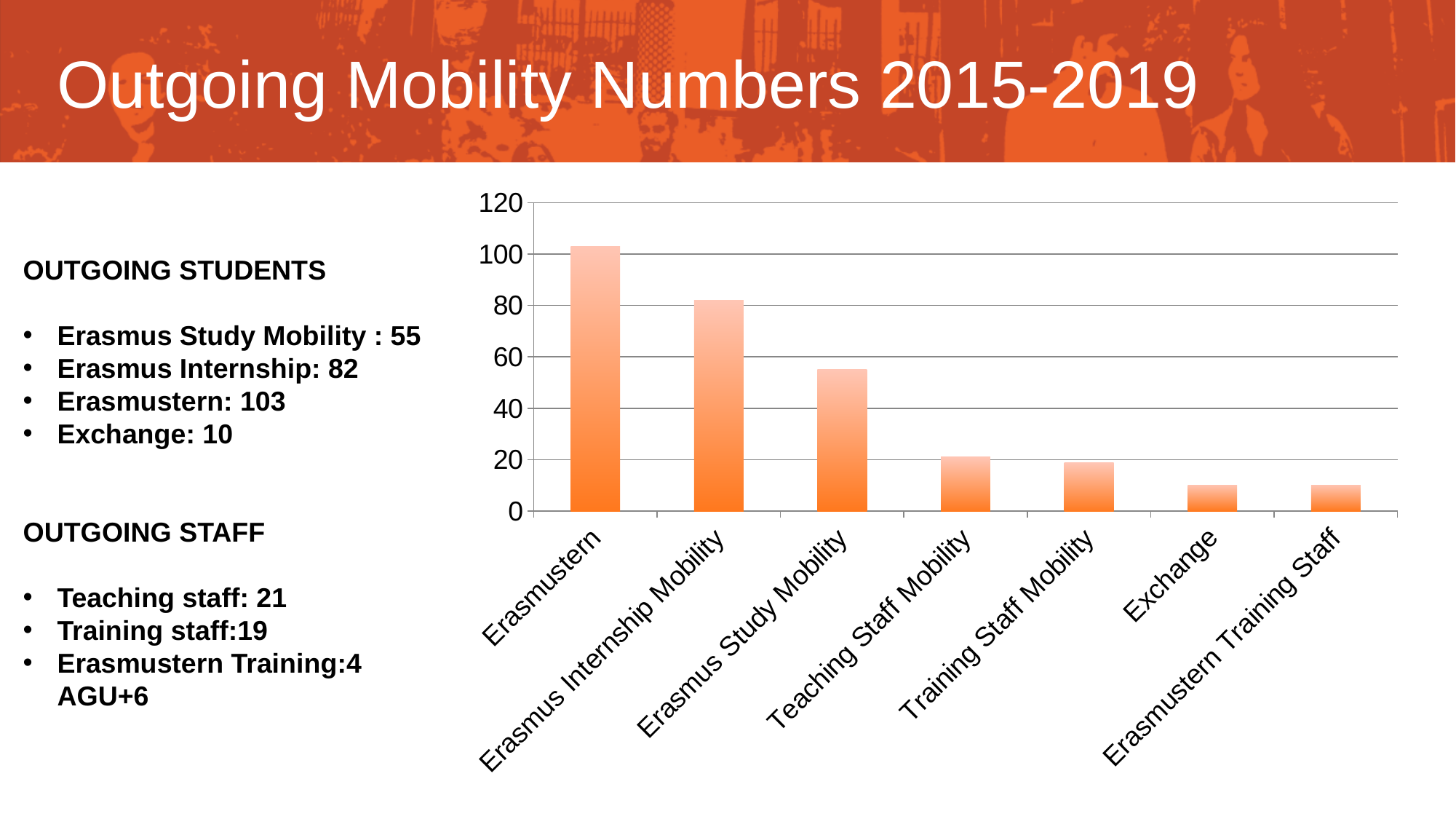
How many categories are plotted on the x axis of the chart? 7 Is the value for Teaching Staff Mobility greater or less than 20? greater Is the value for Erasmus Study Mobility greater or less than 60? less Do the bar values generally rise or fall from left to right along the x axis? fall Is the value for Erasmus Internship Mobility greater or less than 80? greater What is the highest value shown on the chart's vertical axis? 120 What kind of chart is shown on the slide? bar chart Which is larger, the bar for Erasmus Internship Mobility or the bar for Erasmus Study Mobility? Erasmus Internship Mobility Which is larger, the bar for Teaching Staff Mobility or the bar for Exchange? Teaching Staff Mobility Which category has the highest bar in the chart? Erasmustern